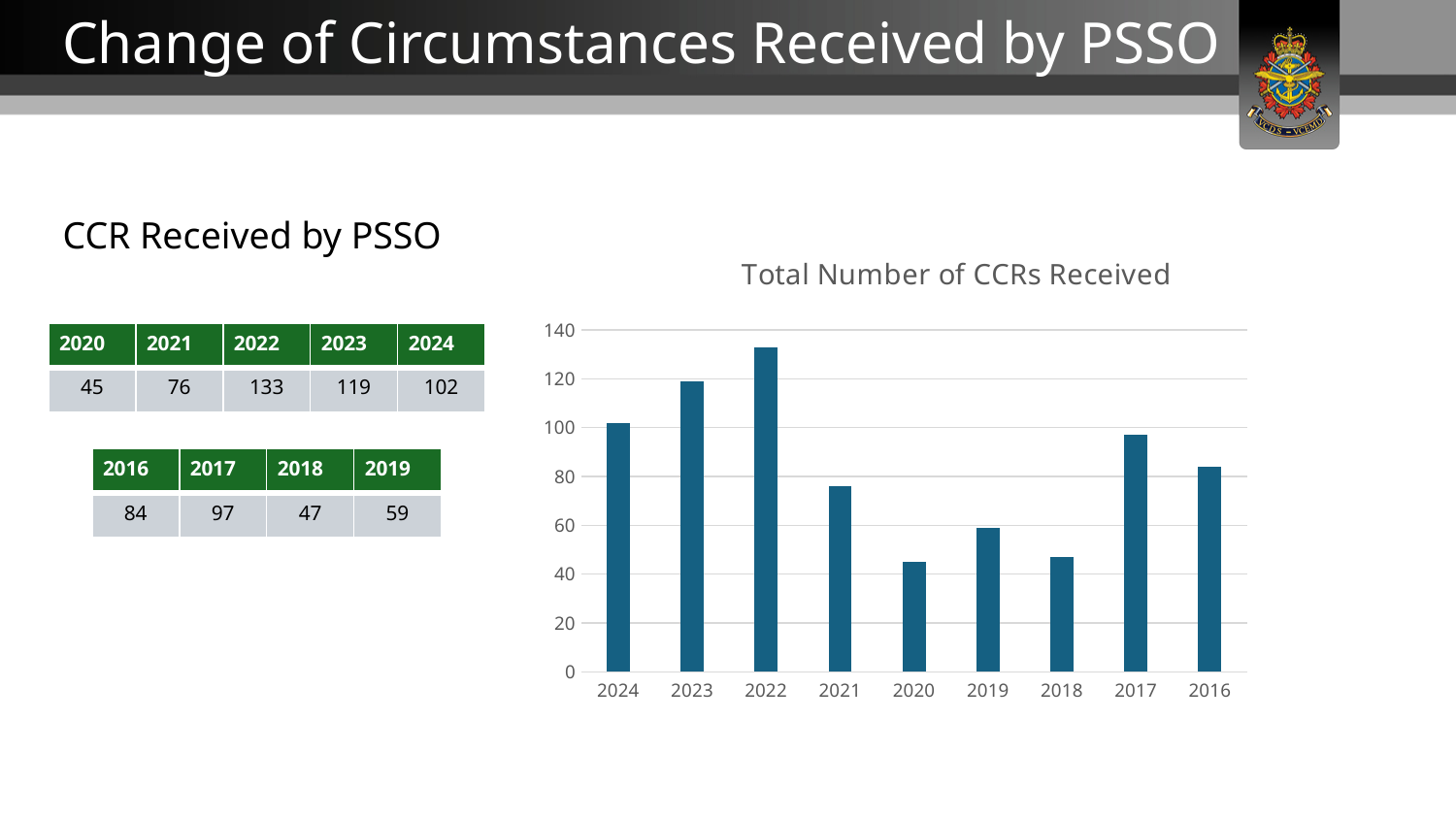
What is the total number of CCRs received in 2022? 133 What is the total number of CCRs received in 2017? 97 In the "Total Number of CCRs Received" chart, is the value for 2023 greater or less than 100? greater How many years (bars) are plotted in the "Total Number of CCRs Received" chart? 9 What is the total number of CCRs received in 2024? 102 Which year has the highest bar in the "Total Number of CCRs Received" chart? 2022 What is the title of the chart on the right side of the slide? Total Number of CCRs Received What is the difference between the number of CCRs received in 2022 and in 2023? 14 Which year had more CCRs received, 2023 or 2017? 2023 What kind of chart is shown under the title "Total Number of CCRs Received"? bar chart Reading the "Total Number of CCRs Received" chart from 2024 to 2020 along the x axis, do the values rise or fall after 2022? fall In the "Total Number of CCRs Received" chart, is the value for 2018 greater or less than 60? less